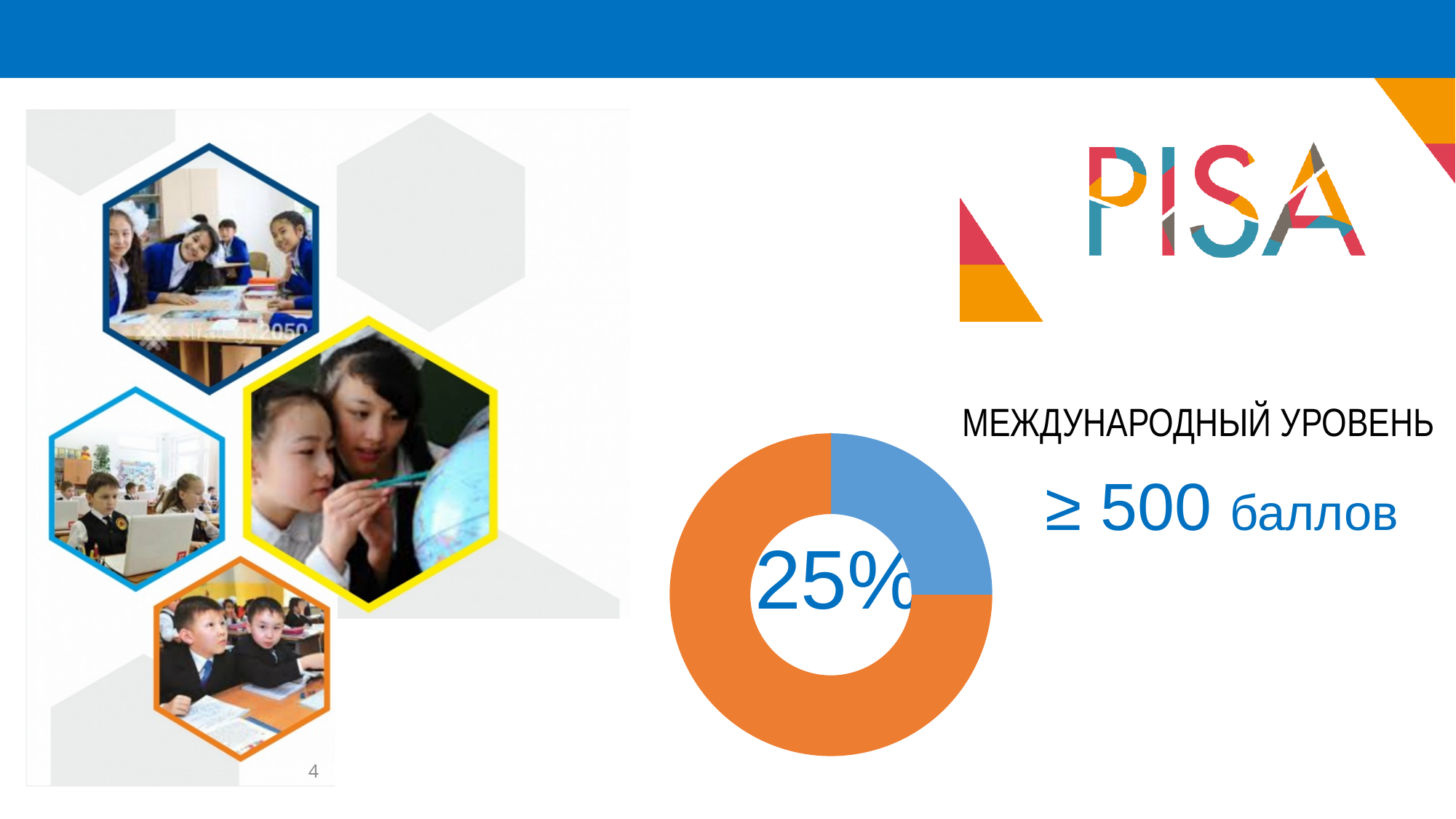
What share of the donut chart does the blue slice represent? 25% What two colours are used for the slices of the donut chart? Blue and orange What kind of chart is shown on the right side of the slide? Donut (pie) chart Which slice of the donut chart is the smallest? The blue slice Which slice of the donut chart is larger, the blue one or the orange one? Orange How many slices does the donut chart have? 2 What percentage is printed in the centre of the donut chart? 25% What share of the donut chart does the orange slice represent? 75% Does the donut chart have a legend? No